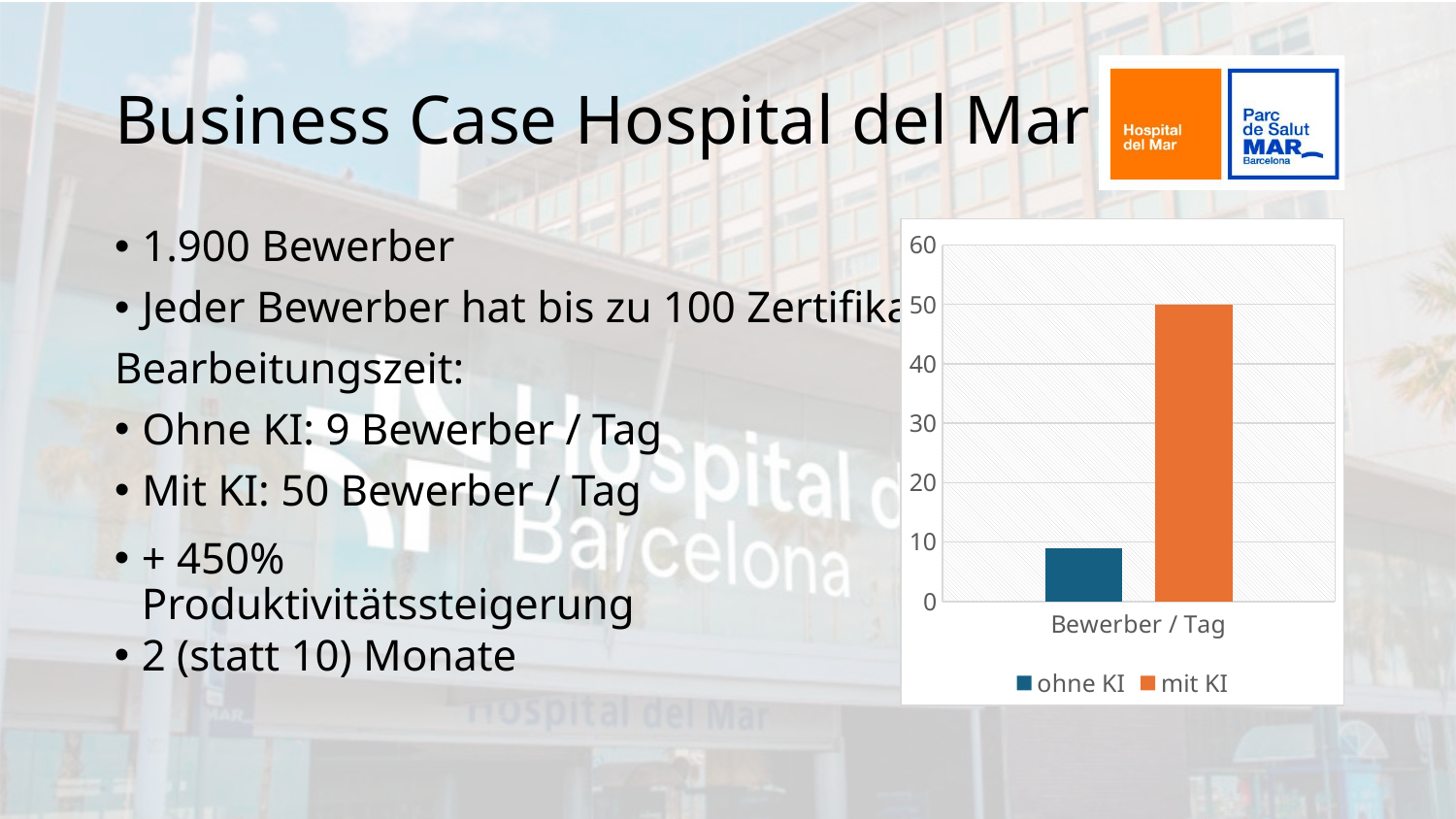
What colour is the 'mit KI' bar in the chart? orange What are the two entries in the chart legend? ohne KI, mit KI Which series has the larger value for 'Bewerber / Tag', 'ohne KI' or 'mit KI'? mit KI Which series has the lowest bar in the chart? ohne KI How many series does the chart legend list? 2 Is the value of the 'ohne KI' bar greater or less than 10? less What is the highest value shown on the chart's vertical axis? 60 Which series has the highest bar in the chart? mit KI What kind of chart is shown on the slide? bar chart What is the value of the 'mit KI' bar for 'Bewerber / Tag'? 50 Is the value of the 'mit KI' bar greater or less than 40? greater How many categories are shown on the x axis of the chart? 1